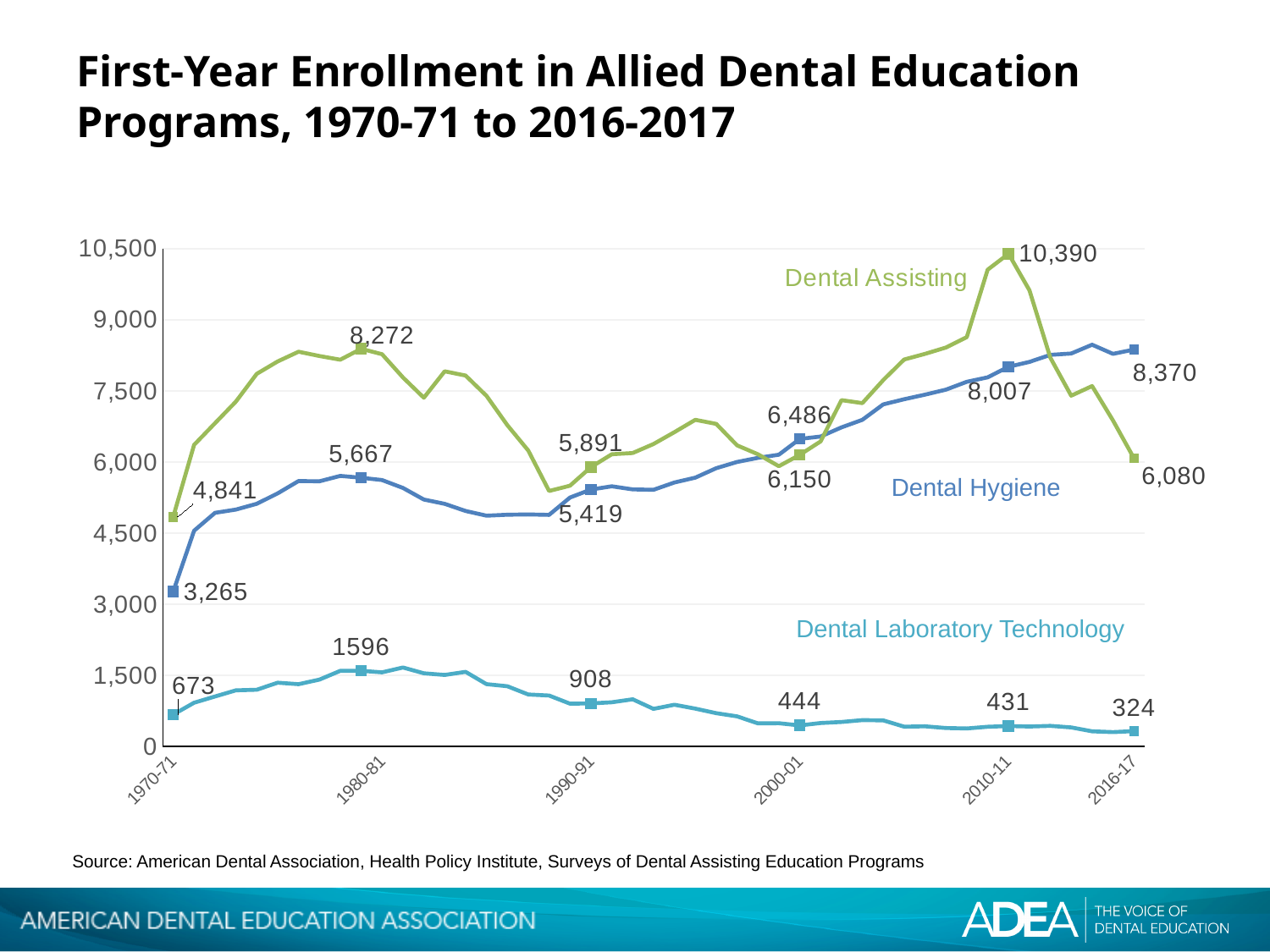
What was first-year enrollment in Dental Hygiene programs in 1970-71? 3,265 What kind of chart is shown on the slide? Line chart What was first-year enrollment in Dental Hygiene programs in 2016-17? 8,370 In which labeled year did Dental Assisting first-year enrollment reach its highest labeled value? 2010-11 Is the Dental Assisting value in 1980-81 greater or less than 7,500? greater What was first-year enrollment in Dental Laboratory Technology programs in 1980-81? 1596 What is the difference between Dental Assisting enrollment in 2010-11 and in 2016-17? 4,310 Which series had higher first-year enrollment in 2016-17, Dental Assisting or Dental Hygiene? Dental Hygiene What was first-year enrollment in Dental Assisting programs in 2010-11? 10,390 Did Dental Hygiene first-year enrollment generally rise or fall from 1970-71 to 2016-17? Rise In which labeled year was Dental Laboratory Technology first-year enrollment lowest? 2016-17 How many series are plotted on the chart? 3